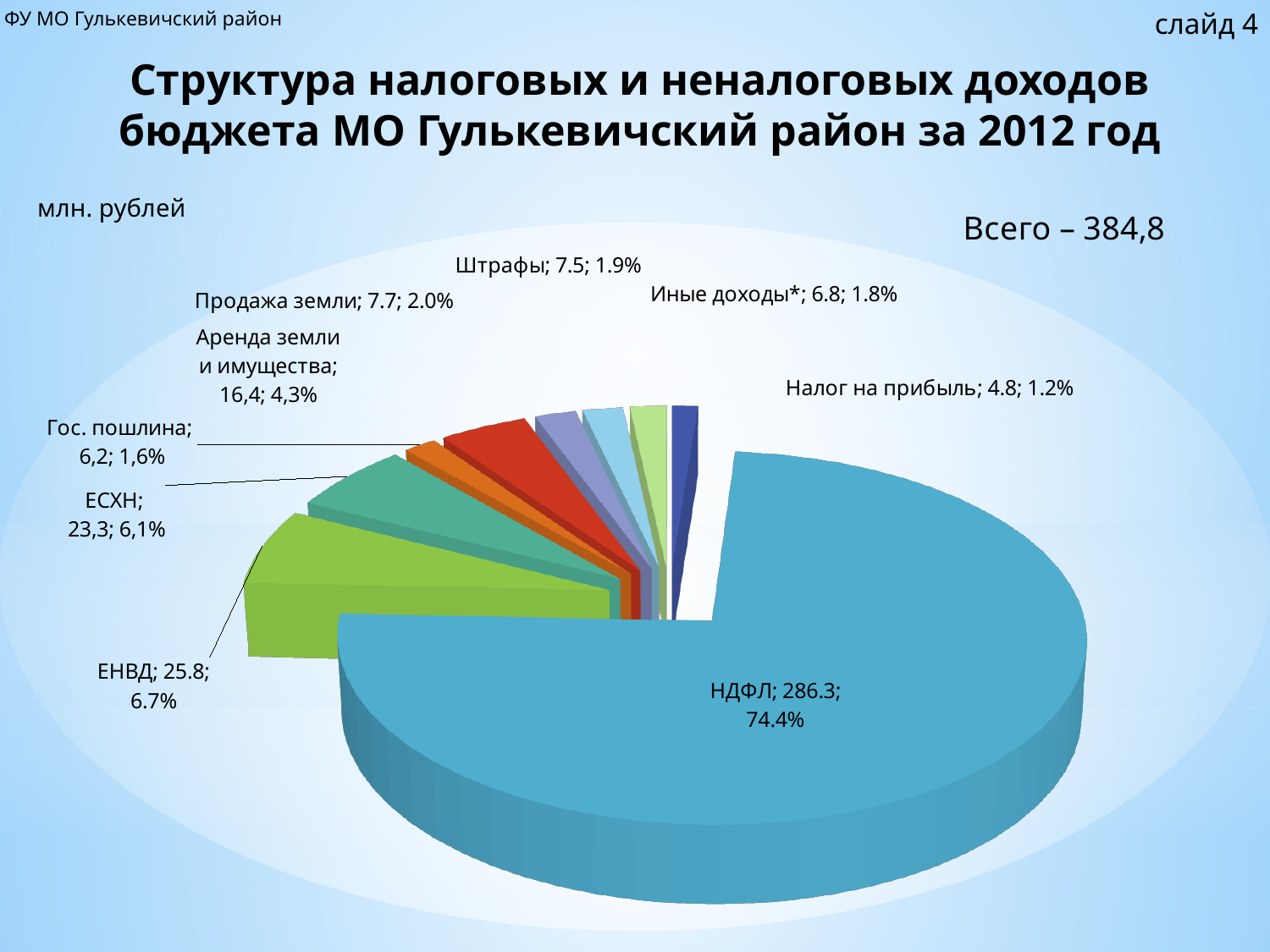
What share of the pie does ЕСХН represent? 6,1% How many categories are shown in the pie chart? 9 Which is larger, the value for Продажа земли or the value for Штрафы? Продажа земли What total value is stated on the slide for all revenues? 384,8 Which category has the smallest slice of the pie? Налог на прибыль What is the difference between the values for ЕНВД and ЕСХН? 2.5 What is the value for Аренда земли и имущества? 16,4 Which category has the largest slice of the pie? НДФЛ What kind of chart is shown on the slide? pie chart What is the value for НДФЛ in million rubles? 286.3 What share of the pie does НДФЛ represent? 74.4% What is the value for ЕНВД? 25.8